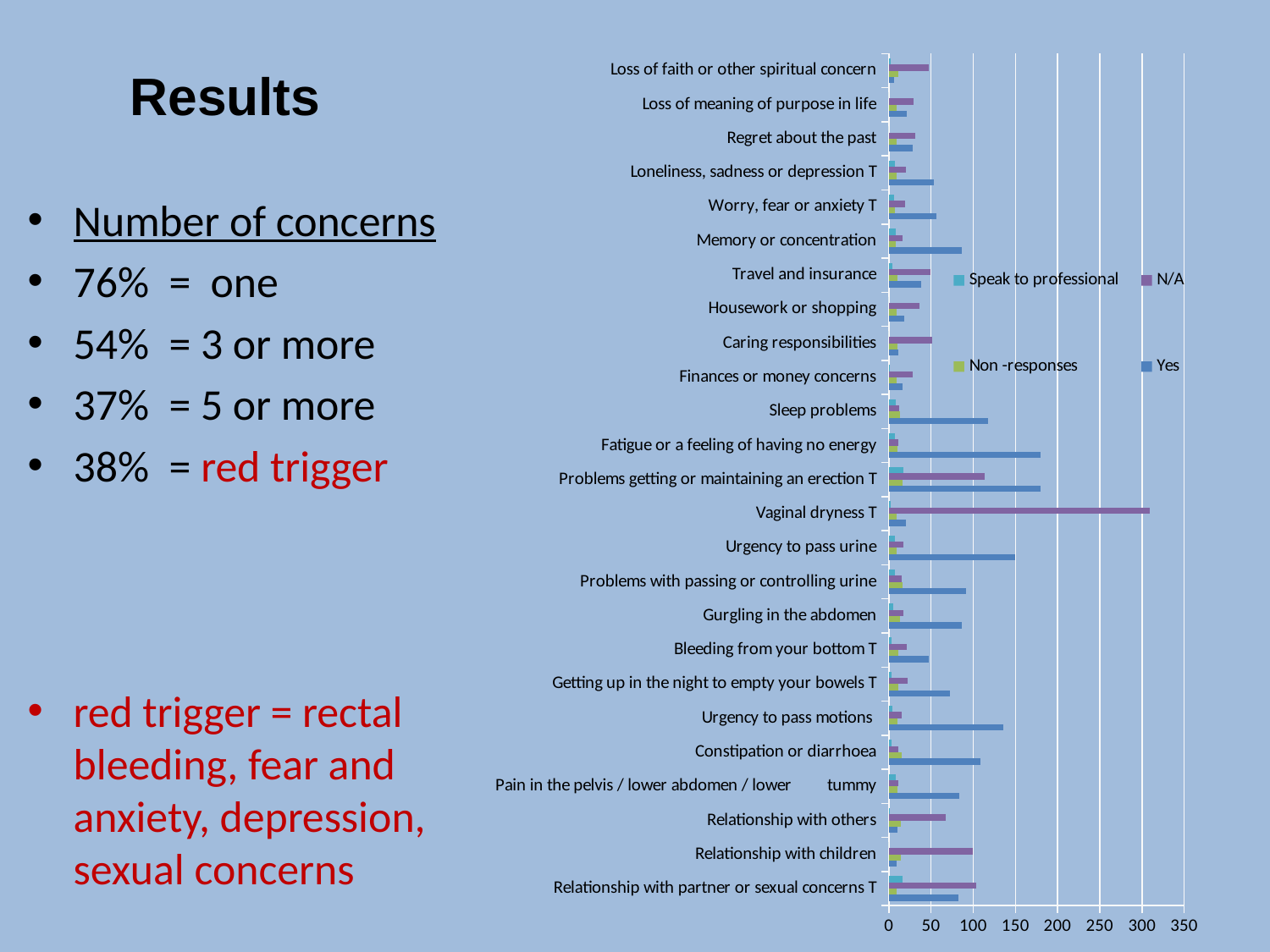
Is the Yes value for Fatigue or a feeling of having no energy greater or less than 150? greater Is the N/A value for Vaginal dryness T greater or less than 300? greater Which series is shown in purple in the chart legend? N/A Is the Yes value for Urgency to pass motions greater or less than 150? less Which category has the longest bar of any series on the chart? Vaginal dryness T Which has the larger Yes value: Sleep problems or Memory or concentration? Sleep problems What kind of chart is shown on the slide? bar chart How many series does the chart legend list? 4 How many categories are plotted on the chart? 25 Which has the larger Yes value: Fatigue or a feeling of having no energy, or Loneliness, sadness or depression T? Fatigue or a feeling of having no energy